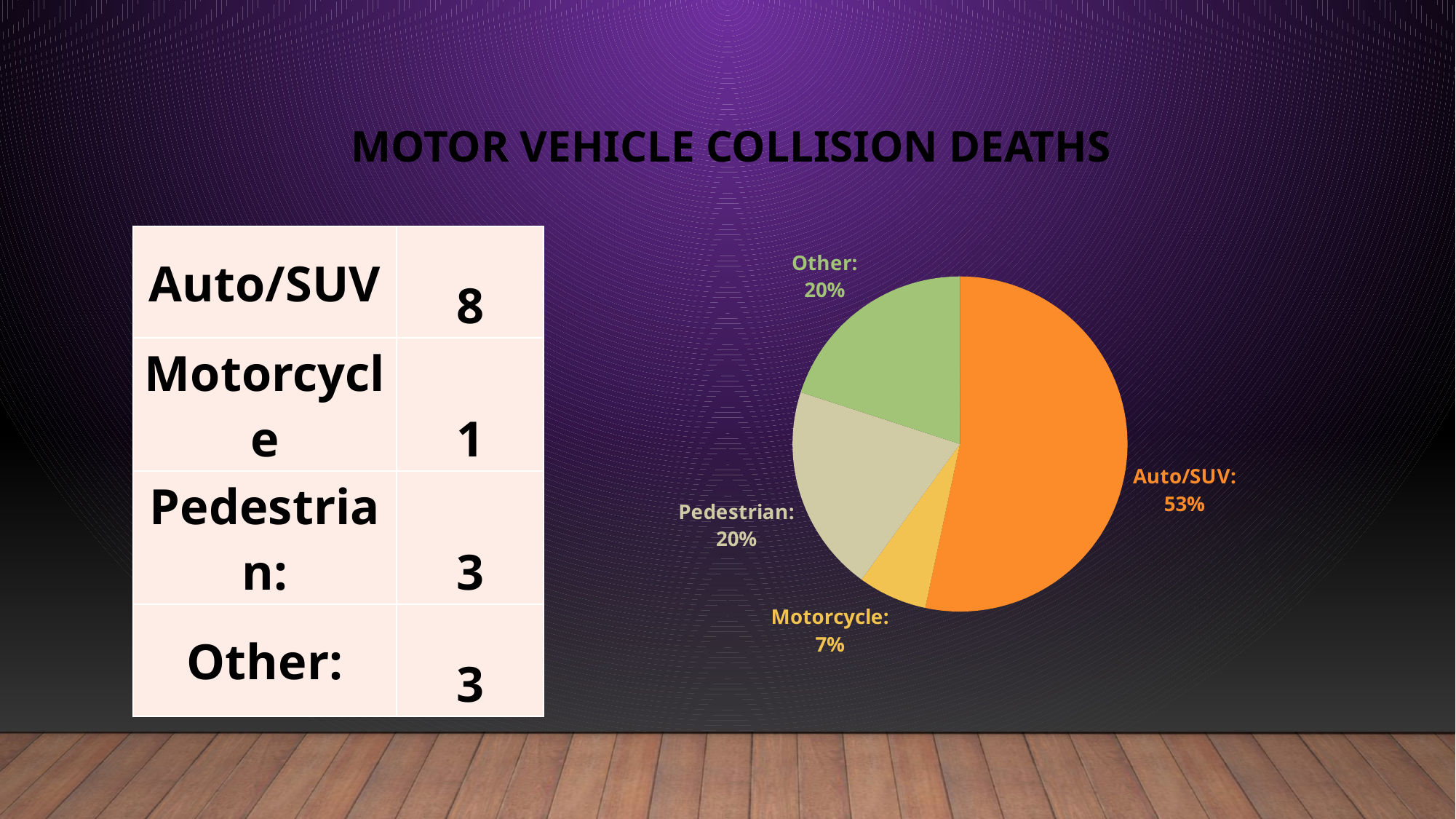
What colour is the Auto/SUV slice of the pie chart? orange What percentage is shown for the Pedestrian slice? 20% What is the difference in percentage points between the Auto/SUV slice and the Motorcycle slice? 46 What percentage is shown for the Motorcycle slice? 7% Which slice is larger, Auto/SUV or Pedestrian? Auto/SUV Which slice is larger, Other or Motorcycle? Other What share of the pie does the Auto/SUV slice represent? 53% How many slices does the pie chart have? 4 Which category has the largest slice of the pie? Auto/SUV What percentage is shown for the Other slice? 20% What kind of chart is shown on the slide? pie chart Which category has the smallest slice of the pie? Motorcycle